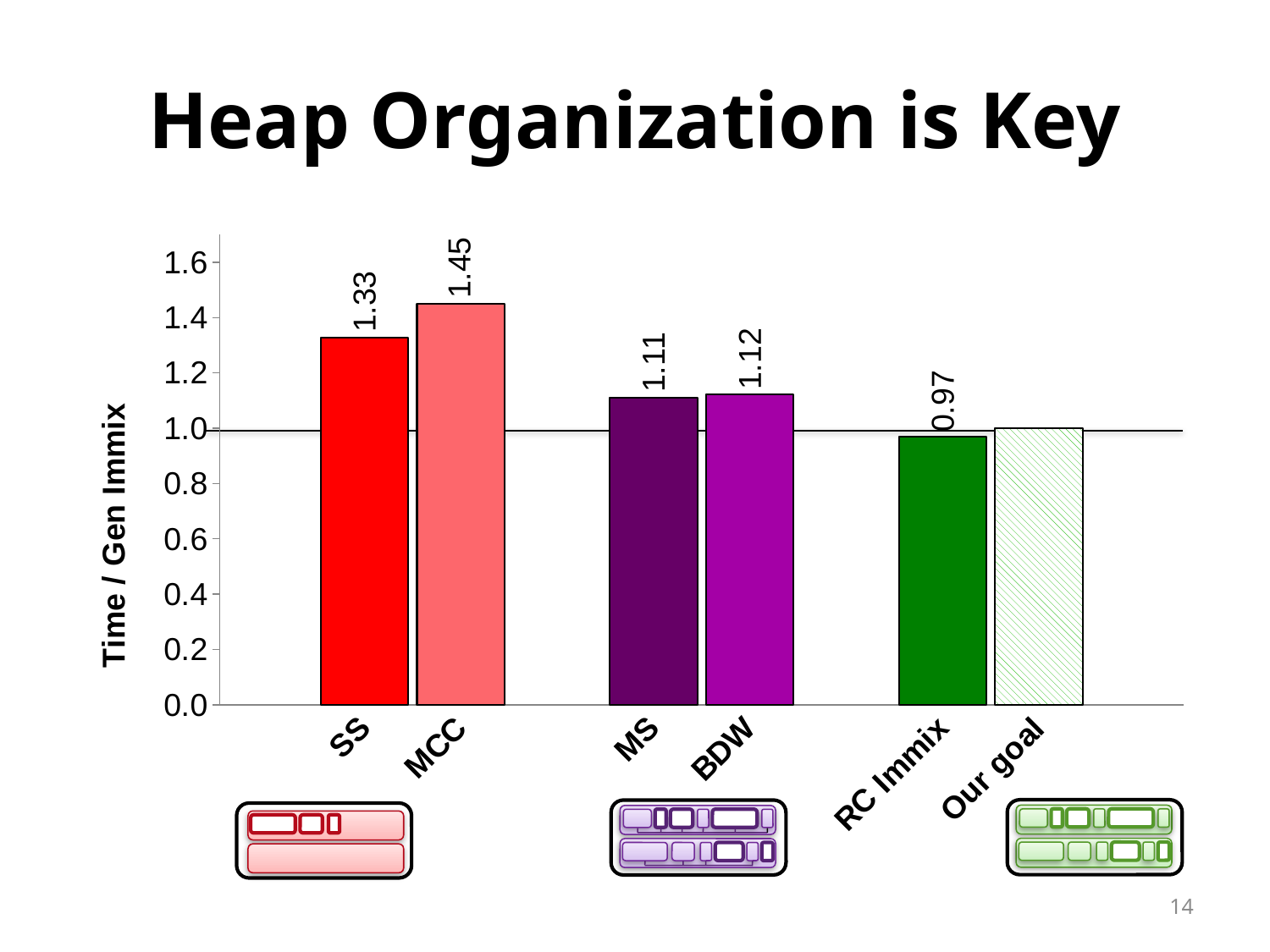
What is the value for BDW? 1.12 What is the difference between the values for MCC and SS? 0.12 What is the value for RC Immix? 0.97 Which category has the highest value? MCC Which is larger, the value for SS or the value for MS? SS Is the value for RC Immix greater or less than 1.0? less What is the value for MCC? 1.45 What is the label on the vertical axis of the chart? Time / Gen Immix What is the value for SS? 1.33 How many bars are shown in the chart? 6 What is the difference between the values for SS and RC Immix? 0.36 What kind of chart is shown on the slide? bar chart